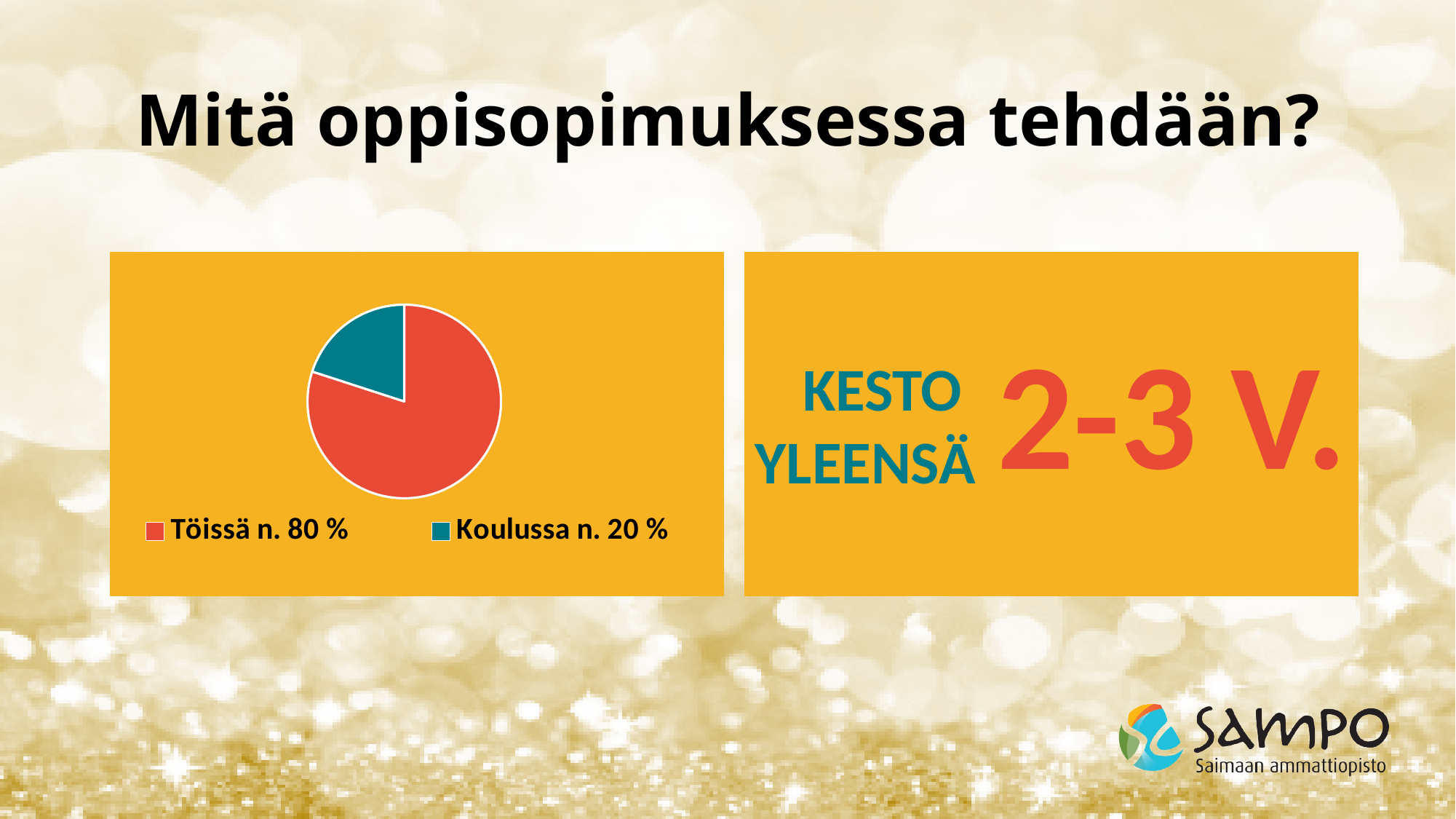
What colour is the Koulussa slice in the pie chart? teal Which slice of the pie chart is the largest? Töissä Which slice of the pie chart is the smallest? Koulussa How many slices does the pie chart have? 2 What kind of chart is shown on the slide? pie chart What share of the pie does the Koulussa slice represent, as printed in the legend? n. 20 % What share of the pie does the Töissä slice represent, as printed in the legend? n. 80 % What colour is the Töissä slice in the pie chart? red What is the difference in percentage points between the Töissä and Koulussa slices? 60 Which is larger in the pie chart, Töissä or Koulussa? Töissä How many entries does the legend of the pie chart list? 2